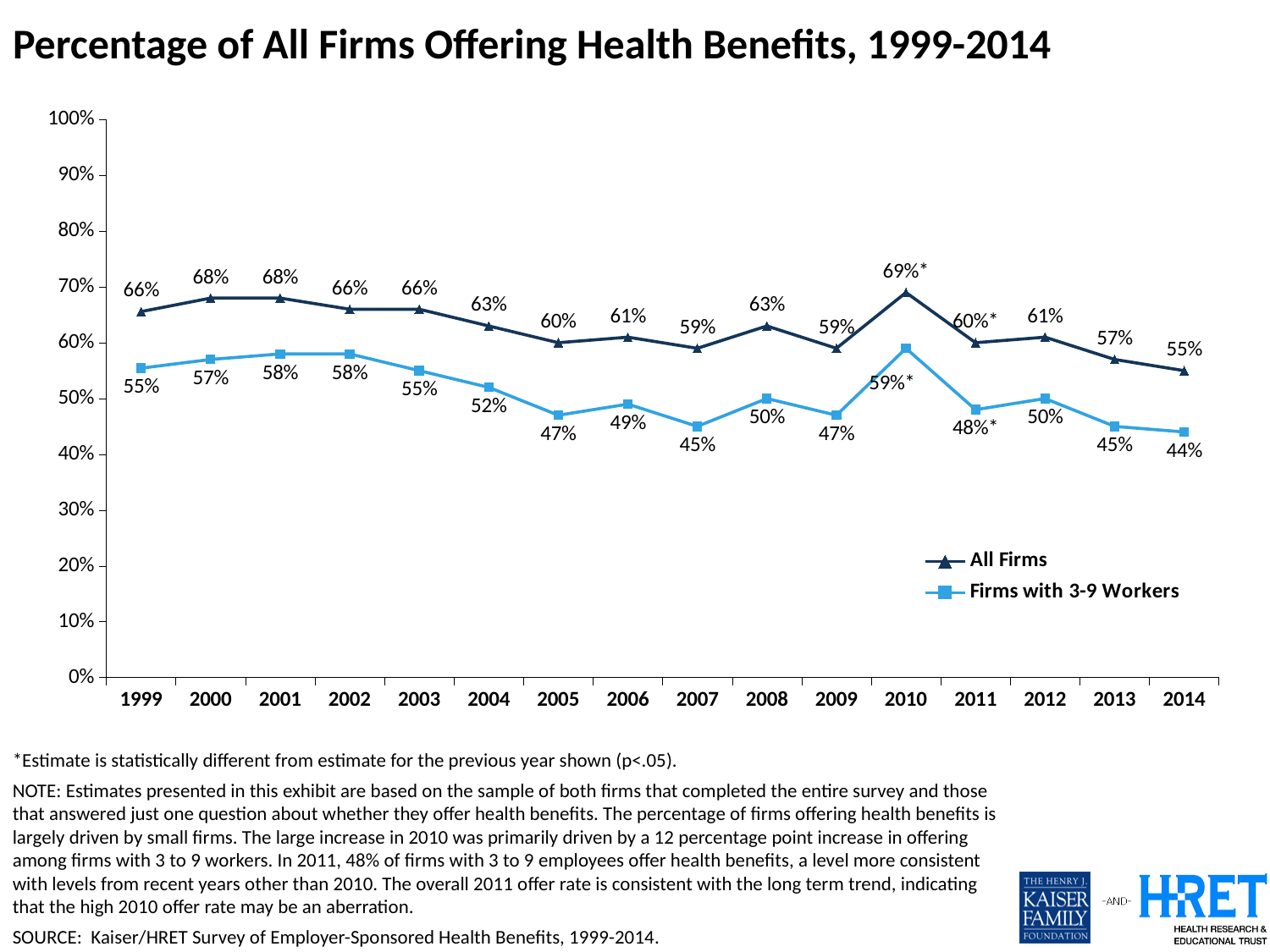
What is the value for Firms with 3-9 Workers in 2014? 44% What is the difference between All Firms and Firms with 3-9 Workers in 2007? 14% What is the value for All Firms in 2010? 69% What type of chart is shown on the slide? line chart Which is larger: the value for Firms with 3-9 Workers in 2010 or in 2011? 2010 In which year is the value for All Firms highest? 2010 What is the value for Firms with 3-9 Workers in 2004? 52% Overall, do the values for All Firms rise or fall from 1999 to 2014? fall How many years are shown on the x axis? 16 How many series does the legend list? 2 Is the value for All Firms in 2014 greater or less than 60%? less In which year is the value for Firms with 3-9 Workers lowest? 2014